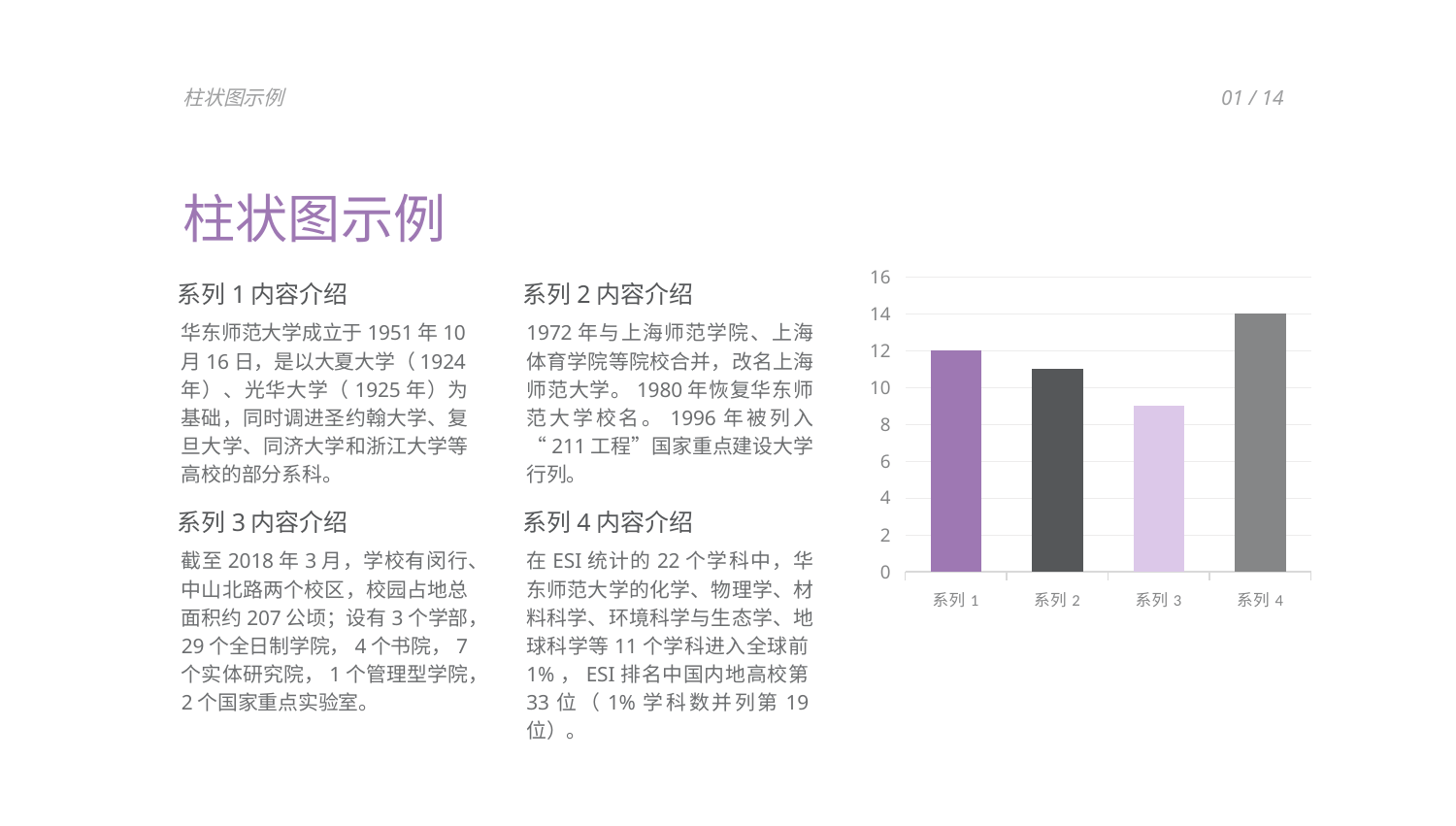
How many categories are shown on the x axis of the chart? 4 Which is larger, the value for 系列 1 or the value for 系列 3? 系列 1 What is the difference between the values for 系列 4 and 系列 1? 2 What is the highest value shown on the chart's vertical axis? 16 Is the value for 系列 2 greater or less than 12? less Is the value for 系列 3 greater or less than 10? less Is the value for 系列 2 greater or less than 10? greater What is the value for 系列 1 in the chart? 12 What is the value for 系列 4 in the chart? 14 Which category has the highest bar in the chart? 系列 4 What kind of chart is shown on the slide? bar chart Which category has the lowest bar in the chart? 系列 3